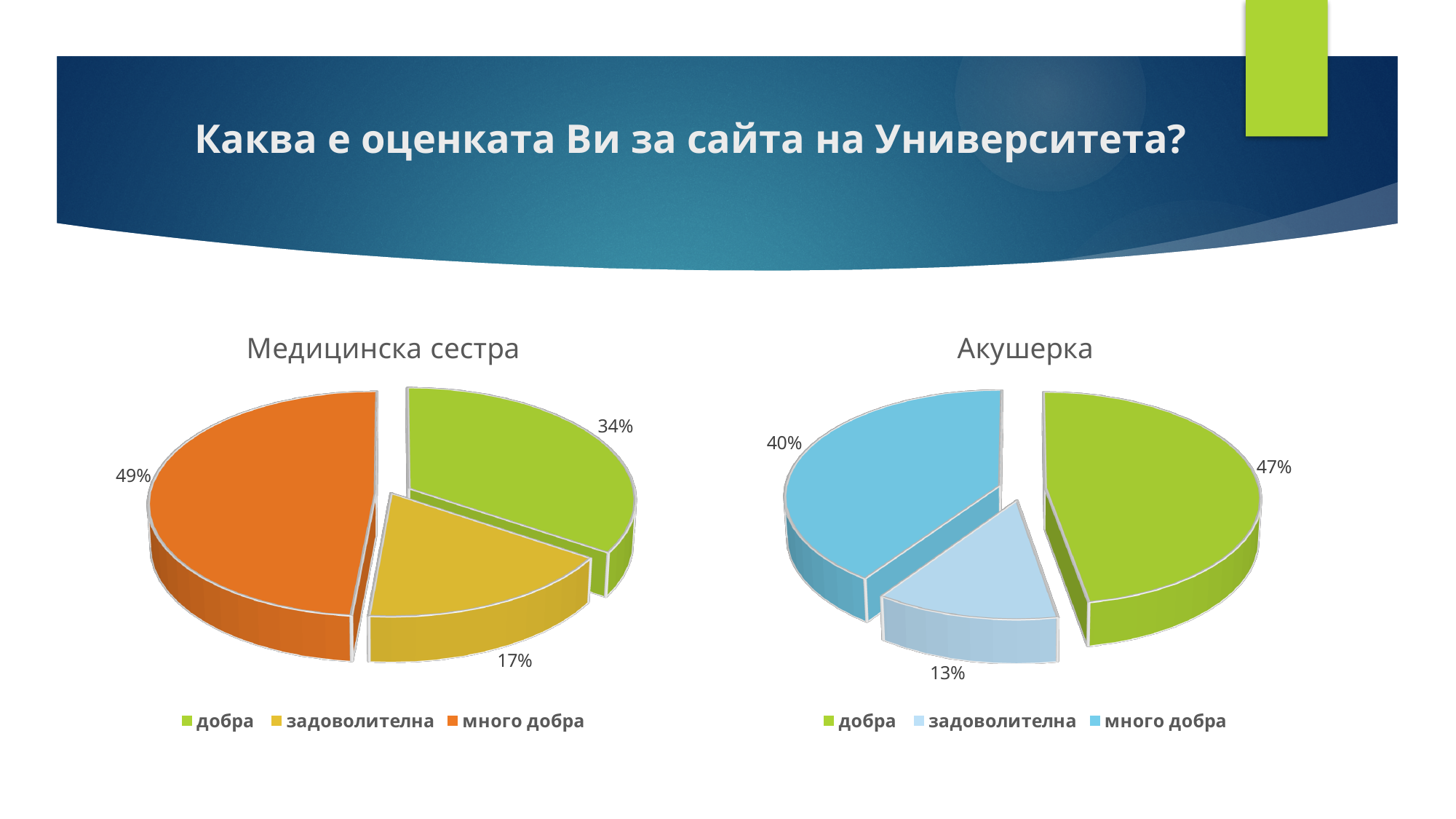
In the "Акушерка" chart, what share is labelled for "добра"? 47% Is the "добра" share larger in the "Медицинска сестра" chart or in the "Акушерка" chart? Акушерка In the "Медицинска сестра" chart, what share is labelled for "много добра"? 49% In the "Акушерка" chart, what share is labelled for "много добра"? 40% In the "Акушерка" chart, which category has the smallest slice? задоволителна How many slices does the "Акушерка" chart have? 3 In the "Медицинска сестра" chart, what is the difference between the "много добра" and "добра" shares? 15% What type of chart is the "Медицинска сестра" chart? Pie chart In the "Медицинска сестра" chart, what share is labelled for "задоволителна"? 17% In the "Медицинска сестра" chart, which category has the largest slice? много добра In the "Акушерка" chart, what is the difference between the "добра" and "задоволителна" shares? 34% What colour is the "много добра" slice in the "Медицинска сестра" chart? Orange